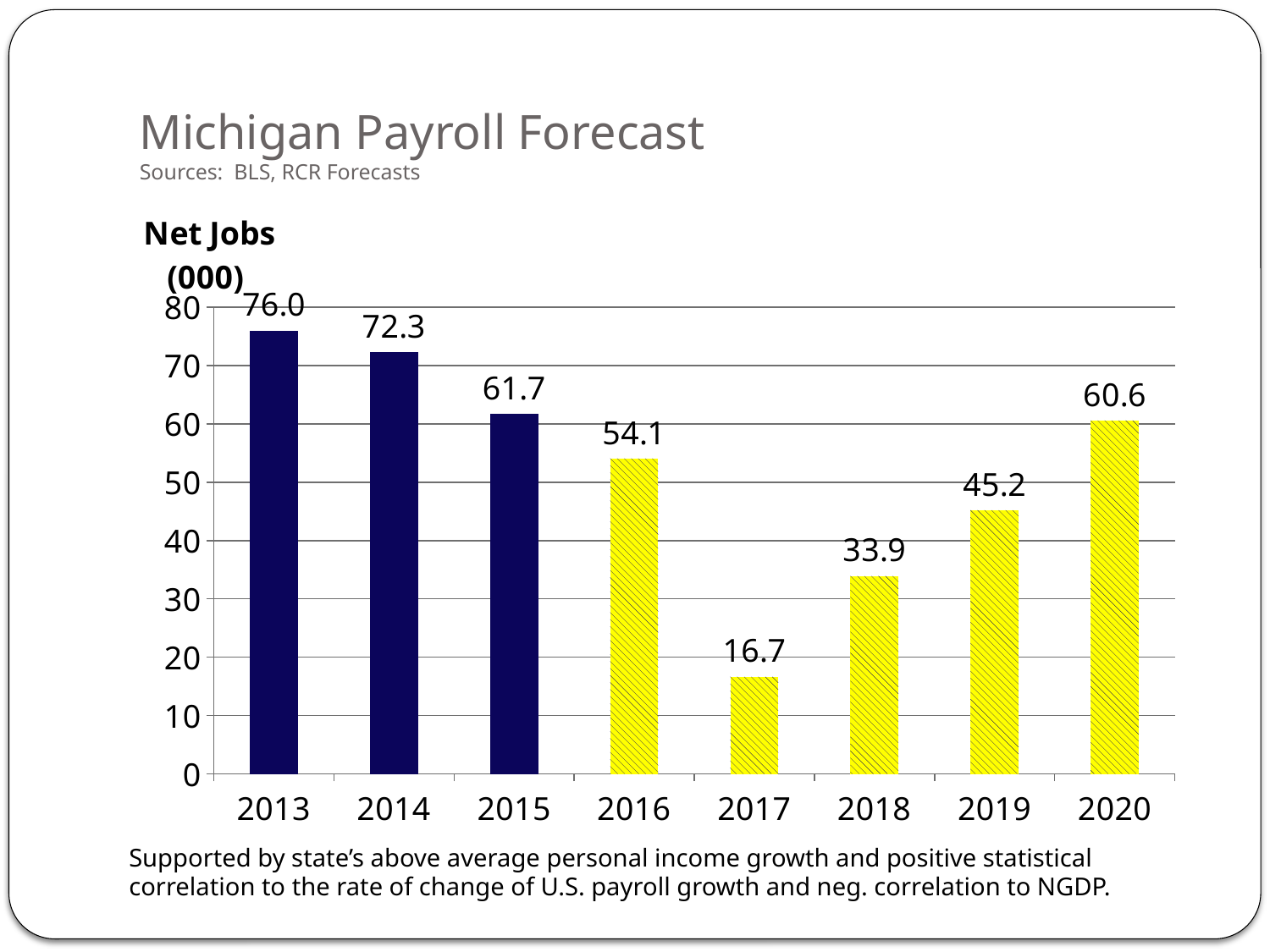
What is the difference between the net jobs values for 2020 and 2019? 15.4 What is the net jobs value for 2013? 76.0 Is the net jobs value for 2015 greater or less than 60? greater What is the net jobs value for 2017? 16.7 Which year has the highest net jobs value? 2013 What is the title of the slide's chart? Michigan Payroll Forecast What is the net jobs value for 2020? 60.6 What is the difference between the net jobs values for 2013 and 2014? 3.7 Which is larger, the net jobs value for 2016 or for 2018? 2016 How many years are shown on the x axis? 8 What kind of chart is shown on the slide? bar chart Which year has the lowest net jobs value? 2017